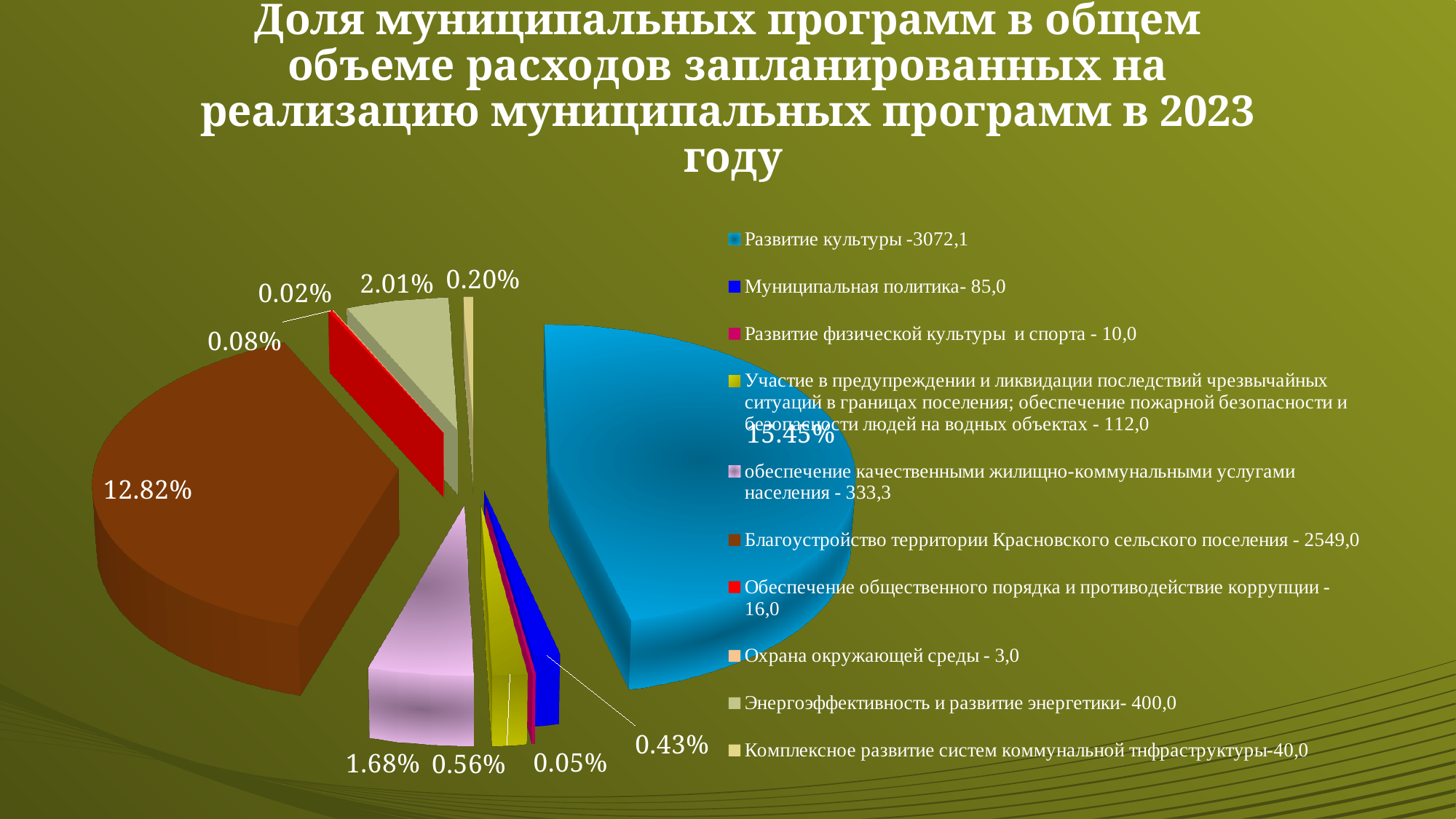
What amount is listed in the legend for Энергоэффективность и развитие энергетики? 400,0 What percentage is shown for Муниципальная политика? 0.43% What percentage is shown for Благоустройство территории Красновского сельского поселения? 12.82% Which program has the largest slice of the pie? Развитие культуры What type of chart is shown on the slide? pie chart What is the difference between the percentages for Развитие культуры and Благоустройство территории Красновского сельского поселения? 2.63% What percentage is shown for обеспечение качественными жилищно-коммунальными услугами населения? 1.68% Which is larger: the percentage for Муниципальная политика or for Развитие физической культуры и спорта? Муниципальная политика What percentage is shown for Энергоэффективность и развитие энергетики? 2.01% Which program has the smallest percentage label on the pie? Охрана окружающей среды What percentage is shown for Развитие культуры? 15.45% How many entries does the legend list? 10